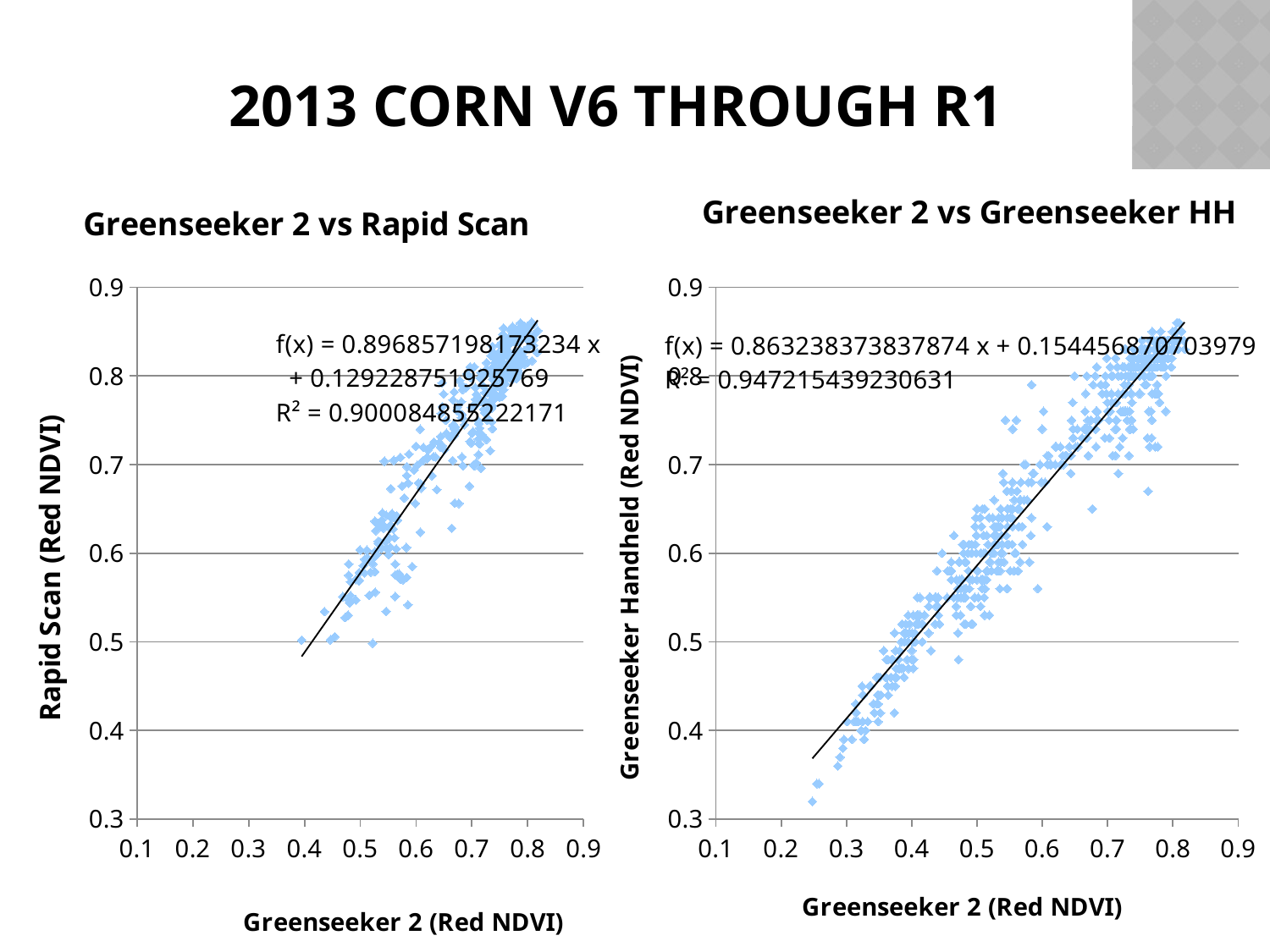
What kind of chart is the left chart, 'Greenseeker 2 vs Rapid Scan'? Scatter chart What is the y-axis label of the right chart 'Greenseeker 2 vs Greenseeker HH'? Greenseeker Handheld (Red NDVI) What kind of chart is the right chart, 'Greenseeker 2 vs Greenseeker HH'? Scatter chart In the left chart 'Greenseeker 2 vs Rapid Scan', do the Rapid Scan values rise or fall as Greenseeker 2 values increase along the x axis? Rise In the left chart 'Greenseeker 2 vs Rapid Scan', what is the trendline equation shown? f(x) = 0.896857198173234 x + 0.129228751925769 In the right chart 'Greenseeker 2 vs Greenseeker HH', what is the R² value shown for the trendline? 0.947215439230631 What is the difference between the R² value in the right chart 'Greenseeker 2 vs Greenseeker HH' and the R² value in the left chart 'Greenseeker 2 vs Rapid Scan'? 0.04713058400846 In the left chart 'Greenseeker 2 vs Rapid Scan', is the highest Rapid Scan value plotted greater or less than 0.8? greater In the left chart 'Greenseeker 2 vs Rapid Scan', what is the R² value shown for the trendline? 0.900084855222171 Which chart shows the higher R² value, 'Greenseeker 2 vs Rapid Scan' or 'Greenseeker 2 vs Greenseeker HH'? Greenseeker 2 vs Greenseeker HH In the right chart 'Greenseeker 2 vs Greenseeker HH', is the lowest Greenseeker Handheld value plotted greater or less than 0.4? less In the right chart 'Greenseeker 2 vs Greenseeker HH', what is the trendline equation shown? f(x) = 0.863238373837874 x + 0.154456870703979